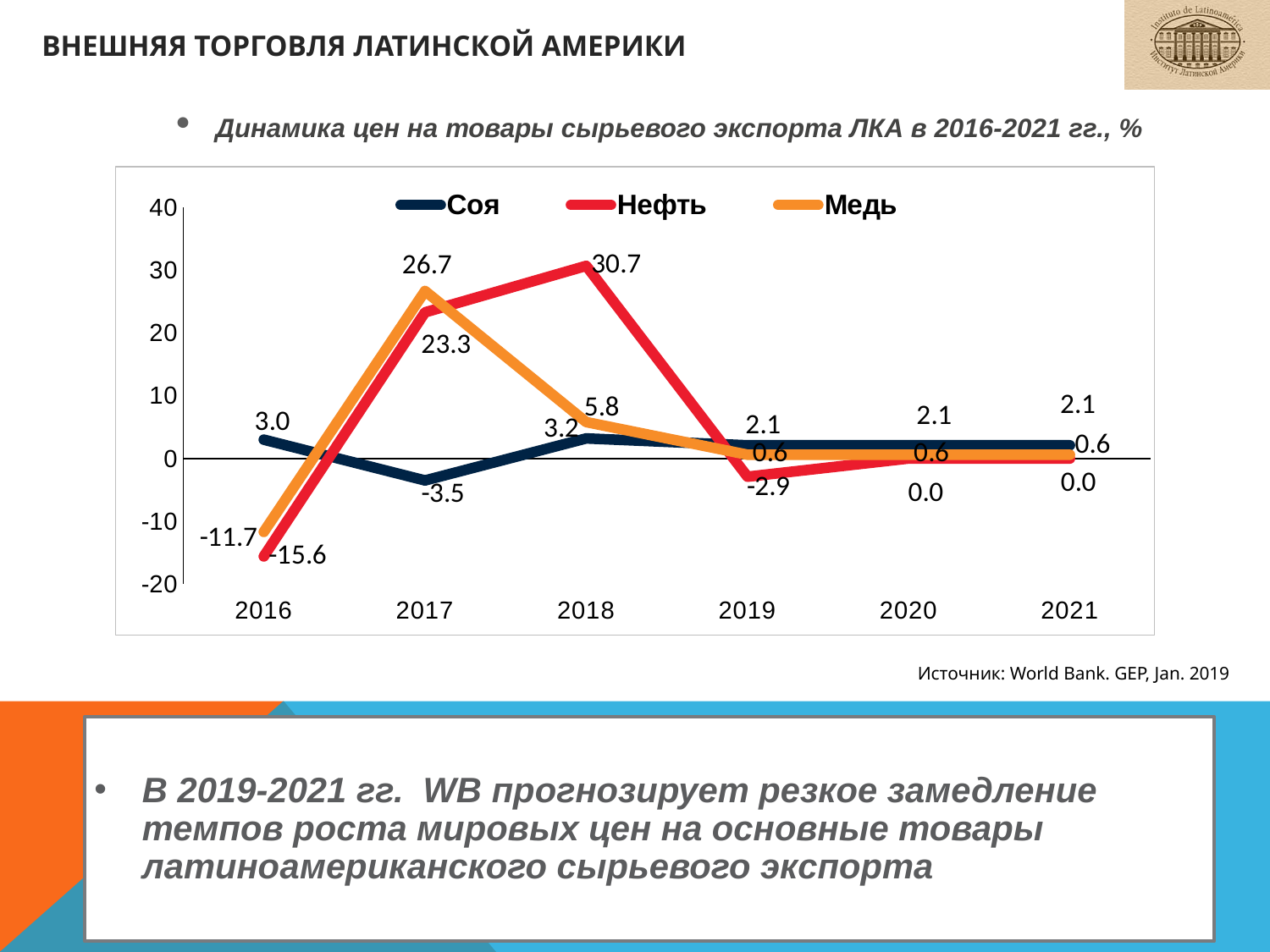
What is the value for Нефть in 2016? -15.6 What is the value for Соя in 2017? -3.5 What is the value for Нефть in 2018? 30.7 Which series is drawn in red? Нефть In which year does Медь have its lowest value? 2016 What is the difference between the Нефть value in 2018 and the Нефть value in 2017? 7.4 How many years are shown on the x axis? 6 How many series does the legend list? 3 What is the value for Медь in 2017? 26.7 What type of chart is shown on the slide? line chart In which year does Нефть reach its highest value? 2018 Which series has the larger value in 2017, Нефть or Медь? Медь